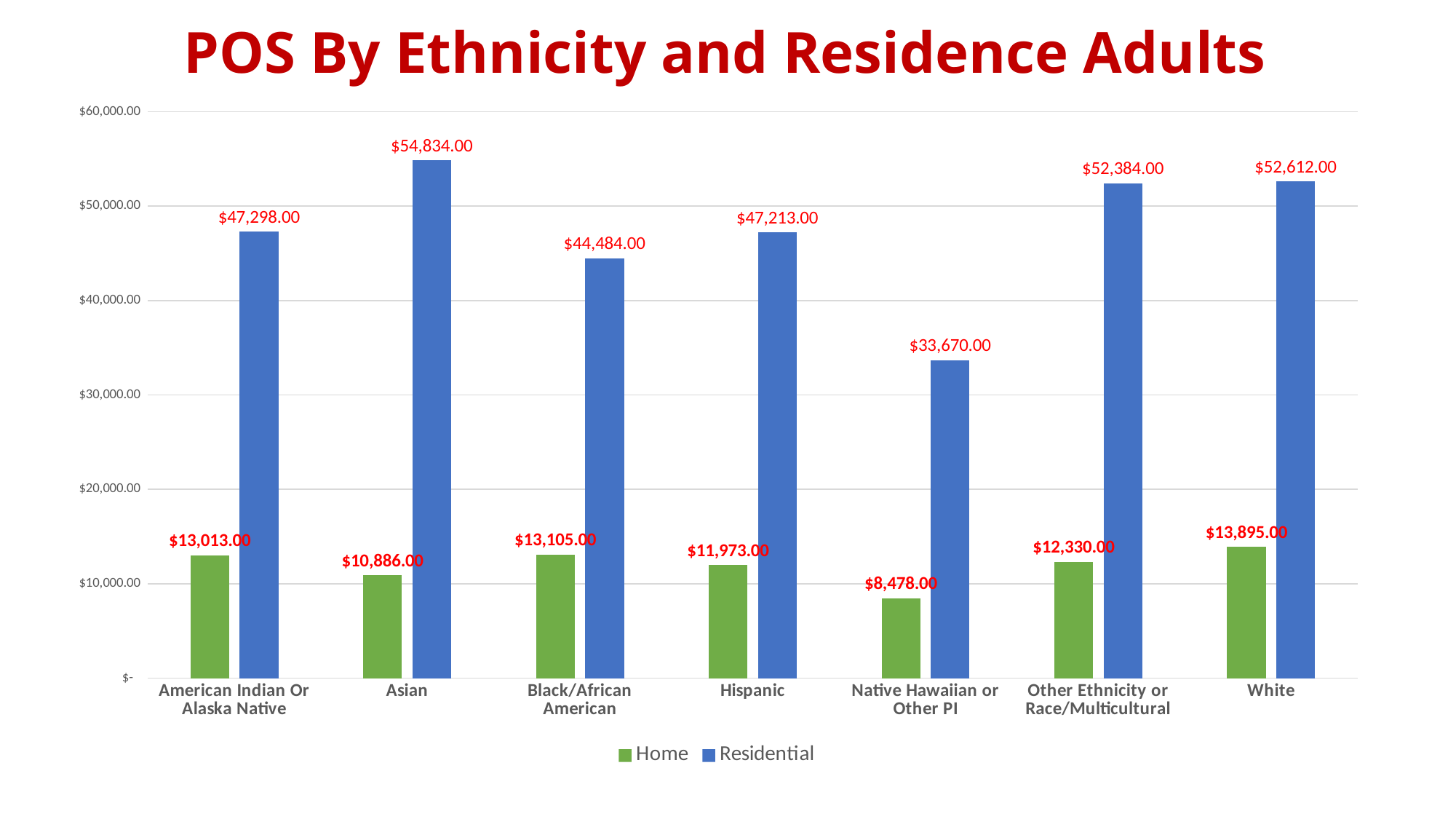
Which is larger, the Home value for White or the Home value for Asian? White What is the Home value for Native Hawaiian or Other PI? $8,478.00 What is the Home value for Other Ethnicity or Race/Multicultural? $12,330.00 Which ethnicity has the lowest Residential value? Native Hawaiian or Other PI How many series does the legend list? 2 Is the Residential value for Native Hawaiian or Other PI greater or less than $30,000.00? greater Which ethnicity has the highest Residential value? Asian What is the difference between the Residential and Home values for Asian? $43,948.00 How many ethnicity categories are shown on the x axis? 7 What is the Residential value for Asian? $54,834.00 What kind of chart is shown on the slide? bar chart Which ethnicity has the lowest Home value? Native Hawaiian or Other PI